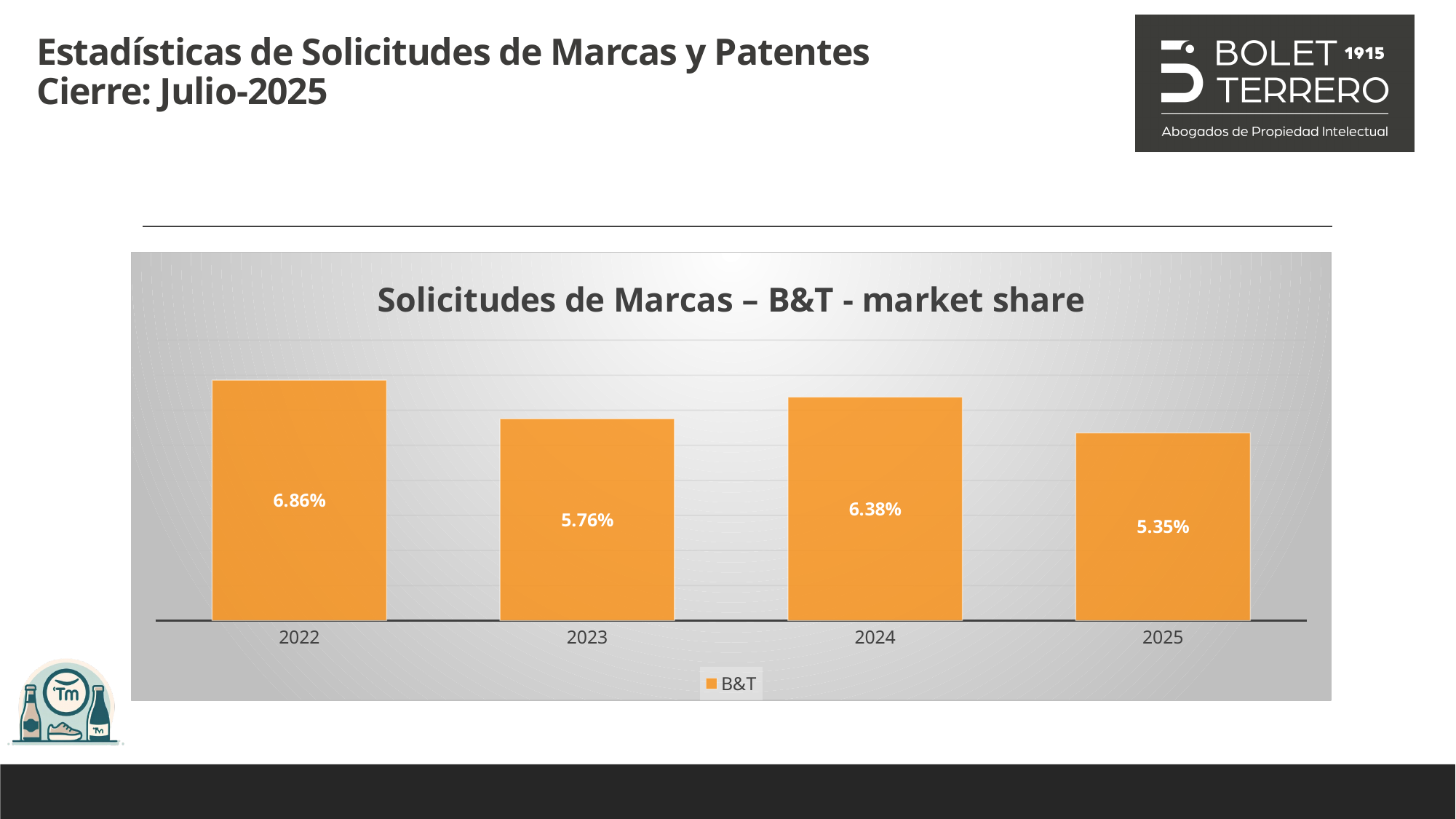
How many series does the chart legend list? 1 Which year has the highest B&T market share? 2022 Which year has the lowest B&T market share? 2025 Which year has a larger B&T market share, 2023 or 2024? 2024 What is the difference between the B&T market share in 2022 and 2025? 1.51% What type of chart is shown on the slide? Bar chart What is the difference between the B&T market share in 2024 and 2023? 0.62% What is the B&T market share value for 2024? 6.38% What is the B&T market share value for 2025? 5.35% How many years are shown on the x axis of the chart? 4 What is the B&T market share value for 2022? 6.86% What is the B&T market share value for 2023? 5.76%